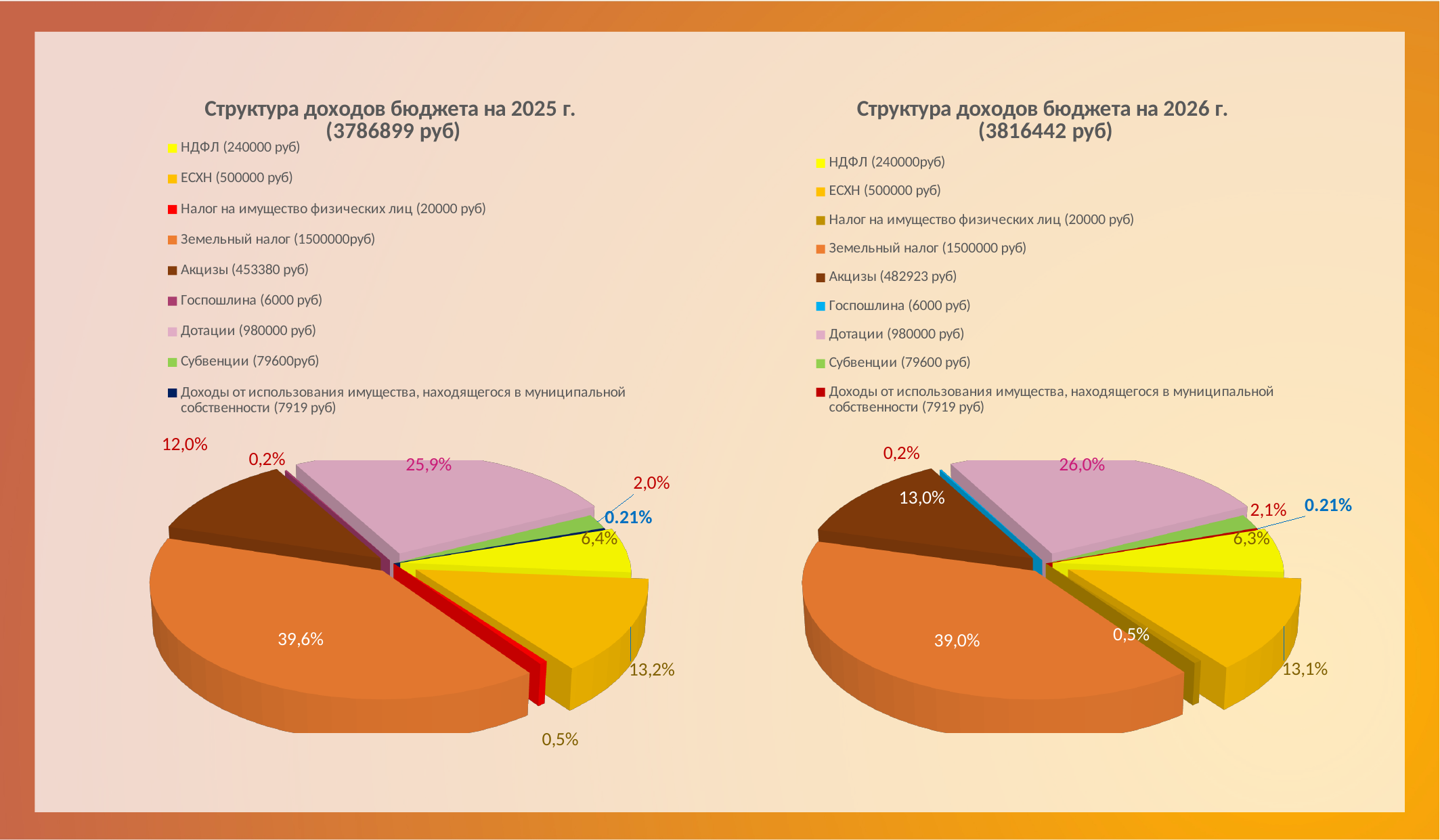
What total budget amount is shown in the title of the chart on the right? 3816442 руб In the 'Структура доходов бюджета на 2025 г.' chart, what is the difference between the share of Дотации and the share of ЕСХН? 12,7 percentage points In the 'Структура доходов бюджета на 2026 г.' chart, what share does Дотации have? 26,0% In the 'Структура доходов бюджета на 2026 г.' chart, what share does Субвенции have? 2,1% In the 'Структура доходов бюджета на 2025 г.' chart, which is larger: the share of Акцизы or the share of ЕСХН? ЕСХН In the 'Структура доходов бюджета на 2025 г.' chart, which category has the largest slice? Земельный налог In the 'Структура доходов бюджета на 2025 г.' chart, what share does НДФЛ have? 6,4% How many categories does the legend of the 'Структура доходов бюджета на 2025 г.' chart list? 9 What kind of chart is the 'Структура доходов бюджета на 2025 г.' chart on the left? pie chart